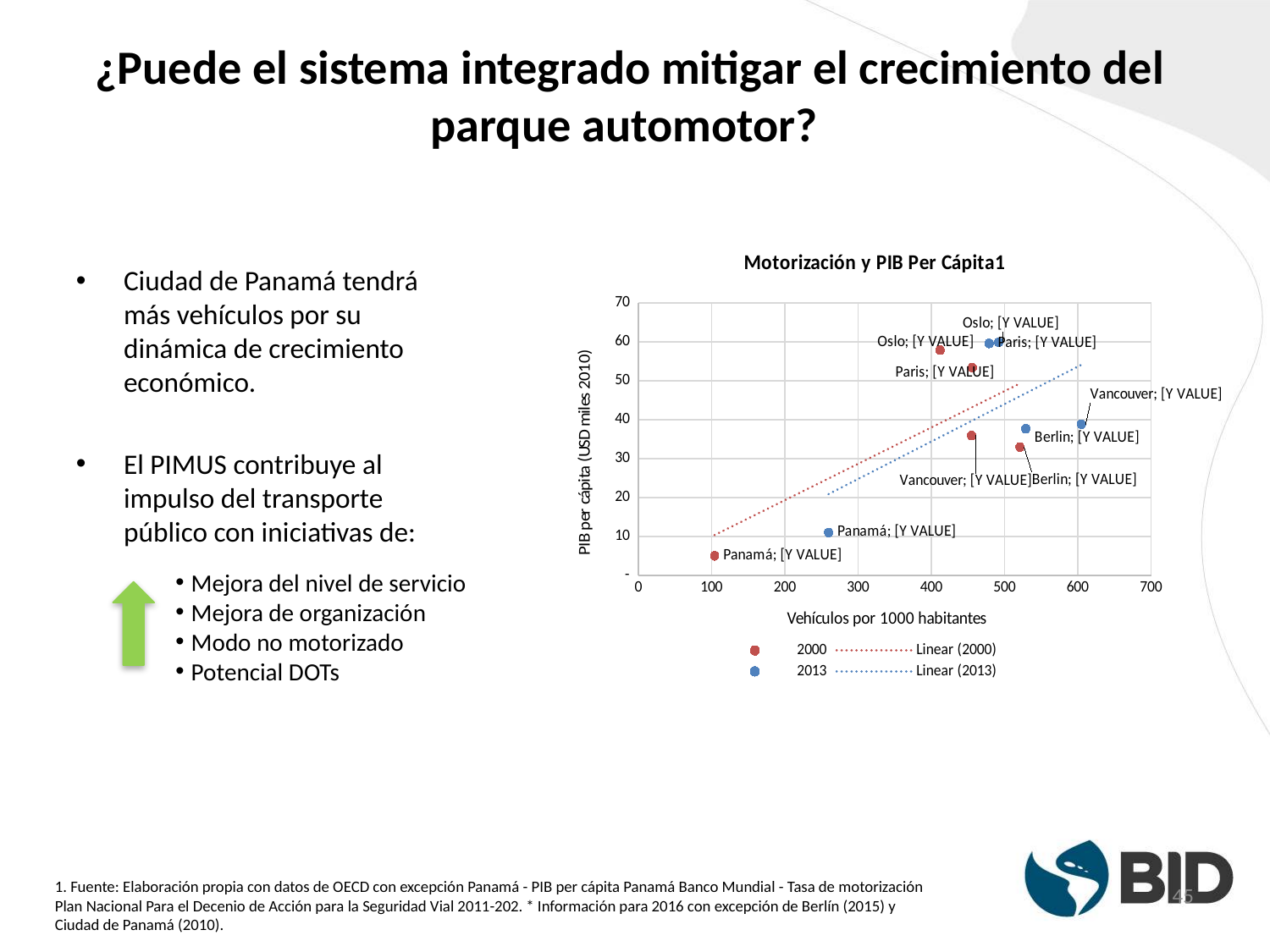
What is the label of the x axis of the chart? Vehículos por 1000 habitantes Do the dotted trend lines in the chart rise or fall as vehicles per 1000 inhabitants increase? Rise How many cities are plotted for the 2000 series? 5 What kind of chart is shown on the slide? Scatter chart Which city has the lowest PIB per cápita in the 2013 series? Panamá Is the PIB per cápita value for Berlin in the 2000 series greater or less than 40? less How many entries does the chart legend list? 4 Which city has the lowest PIB per cápita in the 2000 series? Panamá In the 2000 series, which city has the higher PIB per cápita, Oslo or Berlin? Oslo Is the PIB per cápita value for Panamá in the 2000 series greater or less than 10? less What is the title of the chart? Motorización y PIB Per Cápita1 Is the PIB per cápita value for Oslo in the 2000 series greater or less than 50? greater